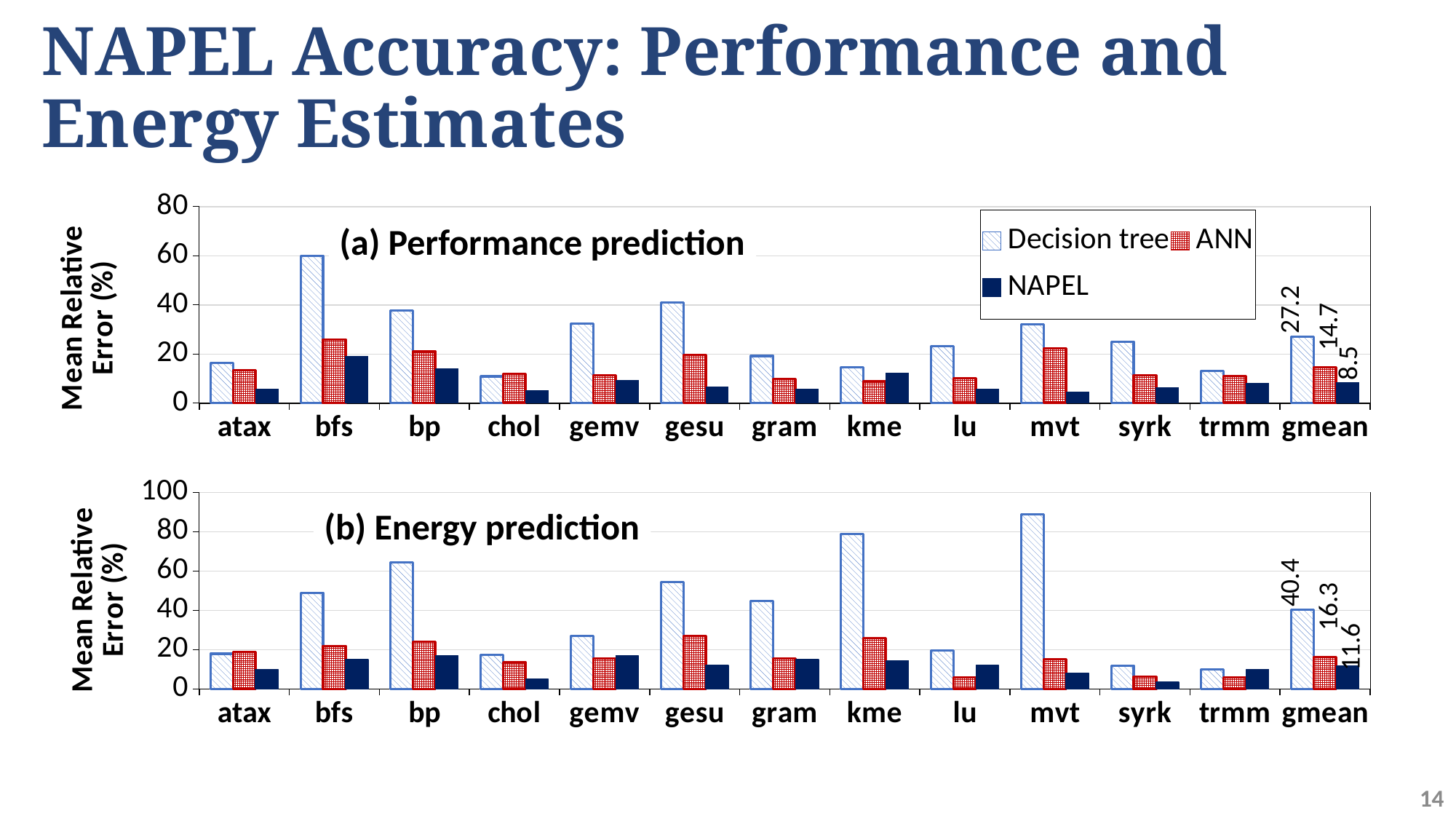
In the (a) Performance prediction chart, which category has the highest Decision tree value? bfs How many categories are shown on the x axis of the (a) Performance prediction chart? 13 What kind of chart is the (b) Energy prediction chart? Bar chart In the (b) Energy prediction chart, is the Decision tree value for kme greater or less than 60? greater In the (a) Performance prediction chart, what is the Decision tree value for gmean? 27.2 In the (a) Performance prediction chart, is the Decision tree value for bfs greater or less than 40? greater In the (b) Energy prediction chart, which is larger for bp: the Decision tree value or the ANN value? Decision tree In the (b) Energy prediction chart, what is the ANN value for gmean? 16.3 In the (a) Performance prediction chart, what is the NAPEL value for gmean? 8.5 In the (b) Energy prediction chart, what is the difference between the Decision tree and NAPEL values for gmean? 28.8 In the (b) Energy prediction chart, which category has the highest Decision tree value? mvt How many series does the legend list? 3